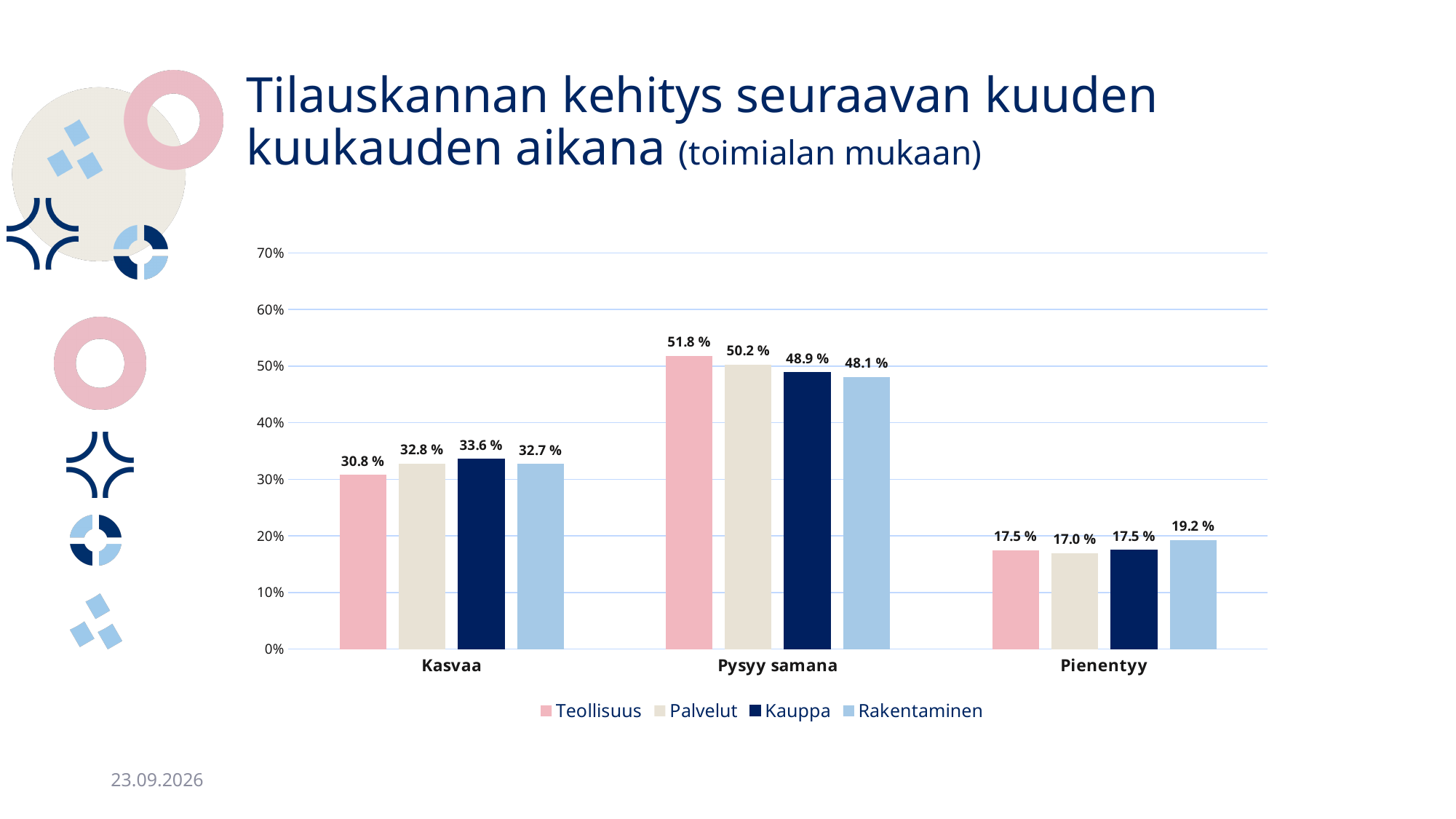
Is the value for Palvelut in the Pysyy samana category greater or less than 40%? greater What is the difference between the Teollisuus and Rakentaminen values in the Pysyy samana category? 3.7 % What is the value for Teollisuus in the Kasvaa category? 30.8 % What is the value for Rakentaminen in the Pienentyy category? 19.2 % What kind of chart is shown on the slide? Bar chart Which colour represents the Kauppa series in the legend? Dark blue How many series does the legend list? 4 How many categories are shown on the x axis? 3 Which series has the lowest value in the Kasvaa category? Teollisuus What is the value for Kauppa in the Pysyy samana category? 48.9 % Which is larger: Palvelut in Kasvaa or Kauppa in Kasvaa? Kauppa in Kasvaa Which series has the highest value in the Pysyy samana category? Teollisuus